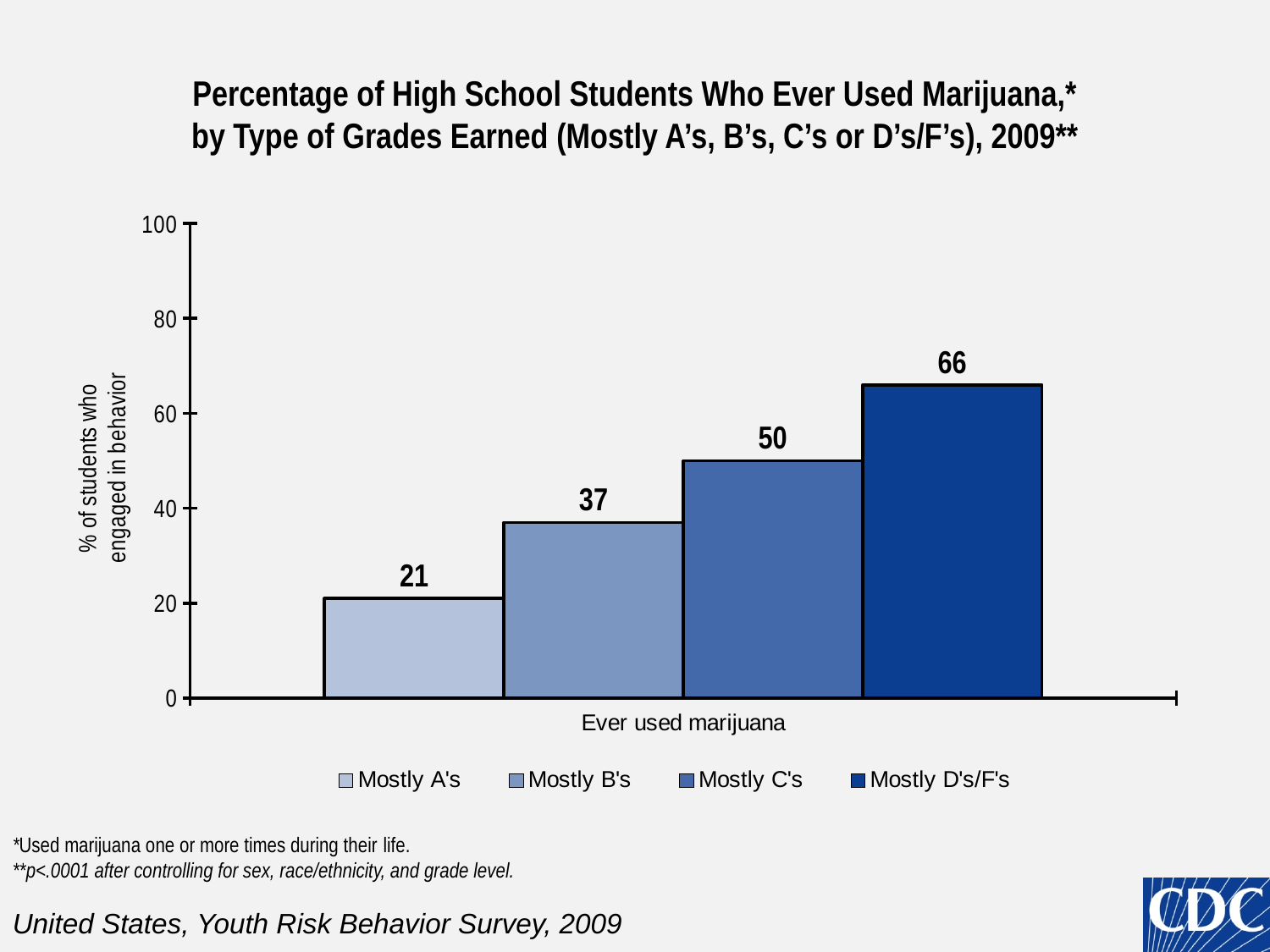
What is the label on the y axis? % of students who engaged in behavior Which grade group has the lowest percentage of students who ever used marijuana? Mostly A's What percentage of students with Mostly A's ever used marijuana? 21 Which is larger, the value for Mostly B's or Mostly C's? Mostly C's What is the value for Mostly C's? 50 What is the value for Mostly D's/F's? 66 What kind of chart is shown on the slide? Bar chart What is the difference between the values for Mostly D's/F's and Mostly A's? 45 Is the value for Mostly D's/F's greater or less than 60? greater What is the value for Mostly B's? 37 How many series does the legend list? 4 Which grade group has the highest percentage of students who ever used marijuana? Mostly D's/F's